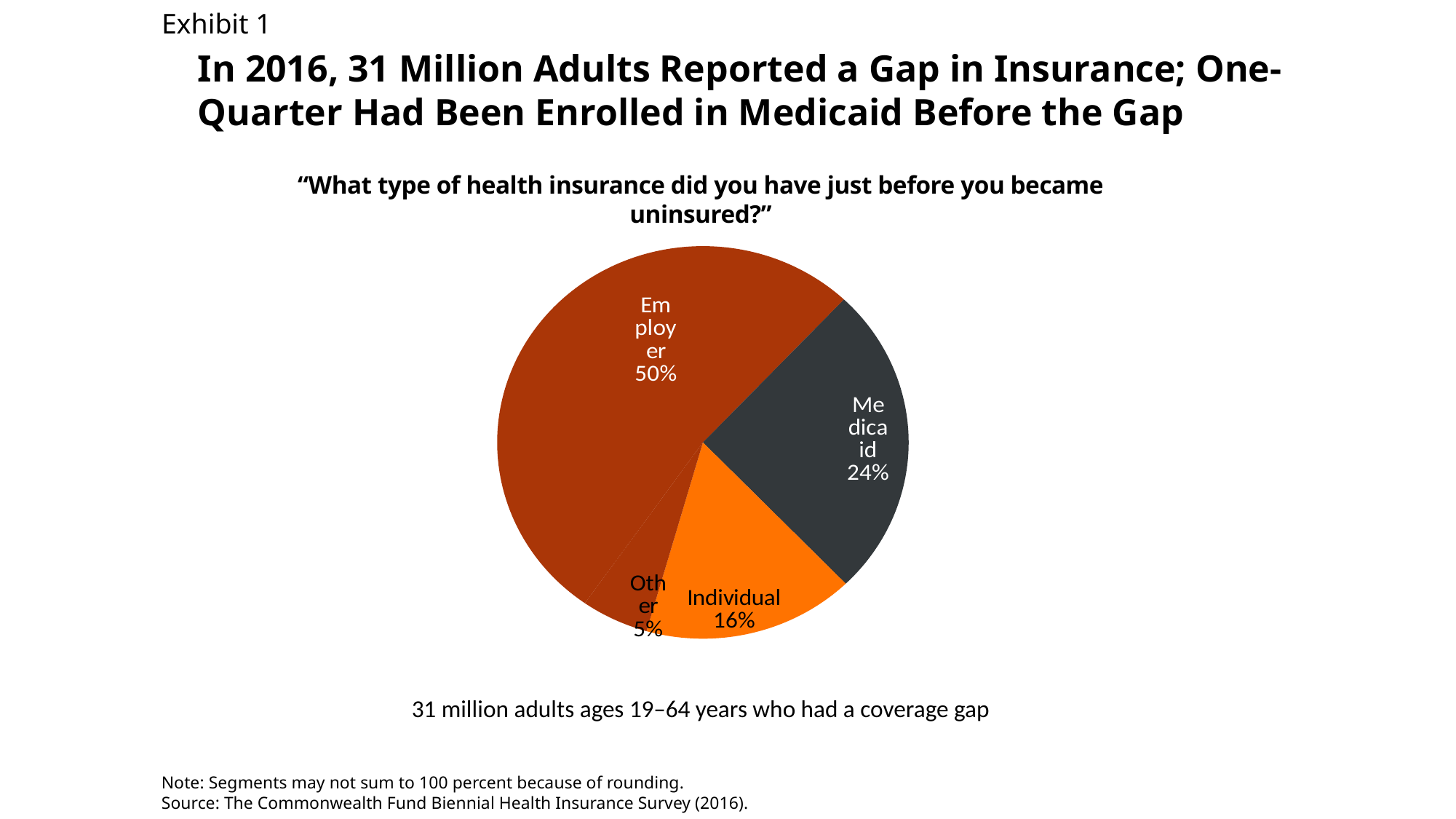
What share of adults had other insurance just before becoming uninsured? 5% What survey question is shown as the chart's title? "What type of health insurance did you have just before you became uninsured?" Which is larger, the Medicaid slice or the Individual slice? Medicaid How many slices does the pie chart have? 4 What type of chart is shown on the slide? Pie chart What is the difference in percentage points between the Employer and Medicaid slices? 26 What is the difference in percentage points between the Individual and Other slices? 11 What share of adults had employer insurance just before becoming uninsured? 50% Which insurance type has the smallest slice of the pie? Other What share of adults had Medicaid just before becoming uninsured? 24% Which insurance type has the largest slice of the pie? Employer What share of adults had individual insurance just before becoming uninsured? 16%